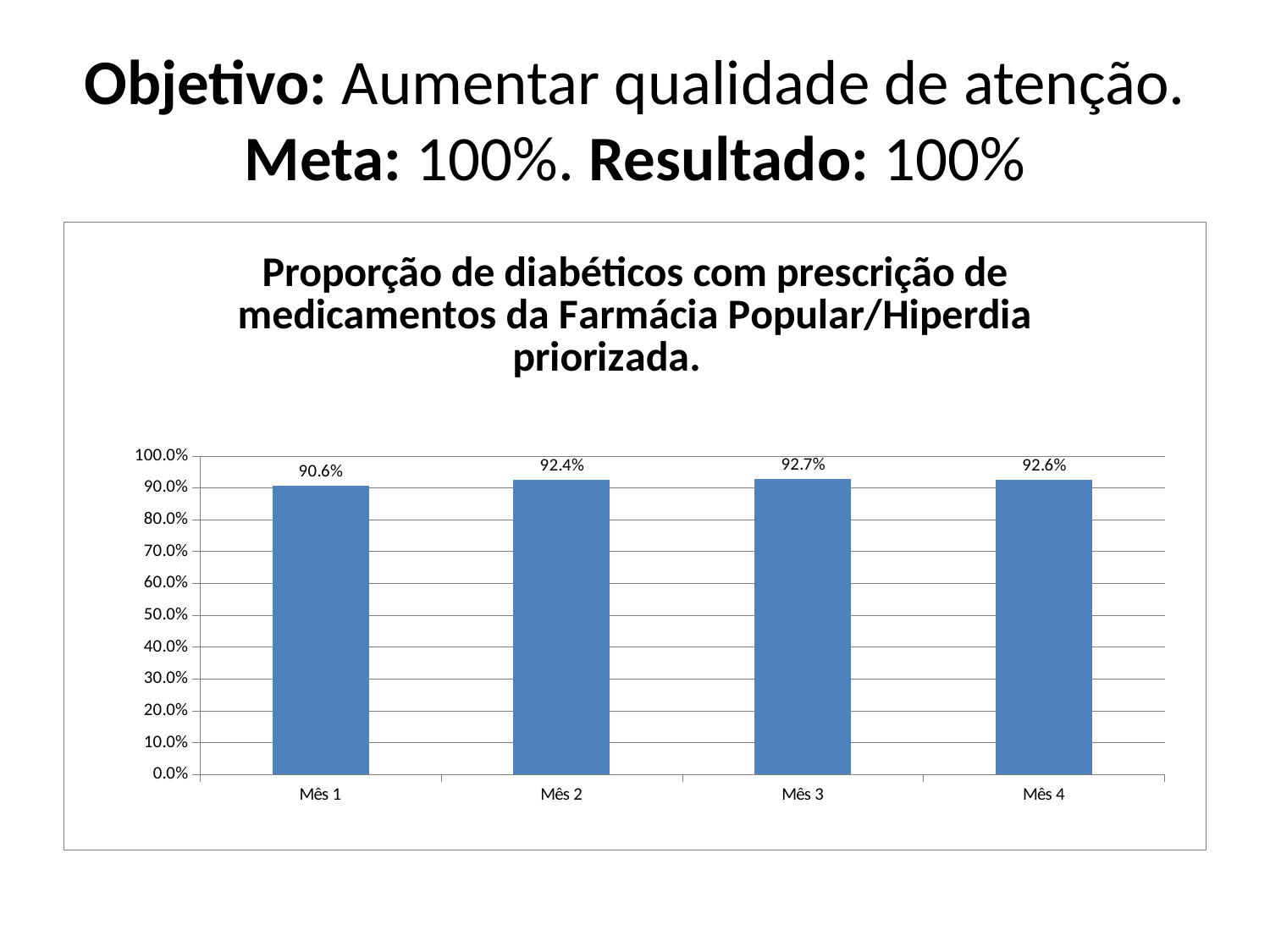
How many months are shown on the x axis? 4 Which is larger, the value for Mês 1 or the value for Mês 2? Mês 2 Which month has the lowest value? Mês 1 What kind of chart is shown on the slide? Bar chart What is the difference between the values for Mês 2 and Mês 1? 1.8% What is the difference between the values for Mês 3 and Mês 4? 0.1% What is the value for Mês 3? 92.7% Is the value for Mês 1 greater or less than 80.0%? greater What is the value for Mês 4? 92.6% Does the value rise or fall from Mês 1 to Mês 2? Rise What is the value for Mês 1? 90.6% What is the title of the chart? Proporção de diabéticos com prescrição de medicamentos da Farmácia Popular/Hiperdia priorizada.